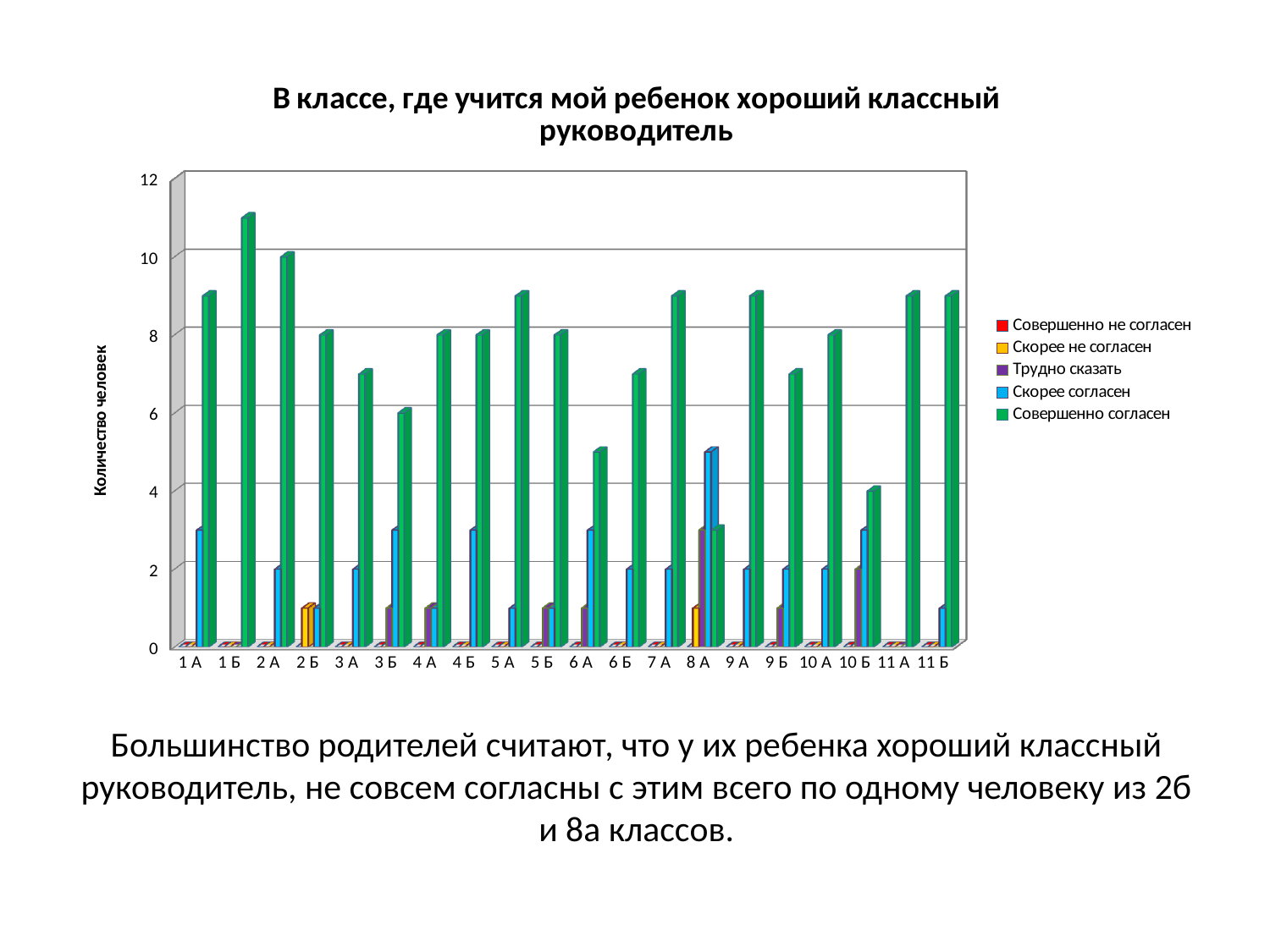
Which is larger: the "Скорее согласен" value for 8 А or for 1 А? 8 А Is the value for "Совершенно согласен" in class 1 Б greater or less than 10? greater What is the label of the vertical axis? Количество человек What is the title of the chart? В классе, где учится мой ребенок хороший классный руководитель Which class has the lowest value for "Совершенно согласен"? 8 А Which is larger: the "Совершенно согласен" value for 1 Б or for 2 А? 1 Б Is the value for "Совершенно согласен" in class 6 А greater or less than 6? less How many series does the legend list? 5 Which class has the highest value for "Совершенно согласен"? 1 Б Is the value for "Скорее согласен" in class 8 А greater or less than 4? greater How many classes (categories) are shown along the x axis? 20 What kind of chart is shown on the slide? bar chart